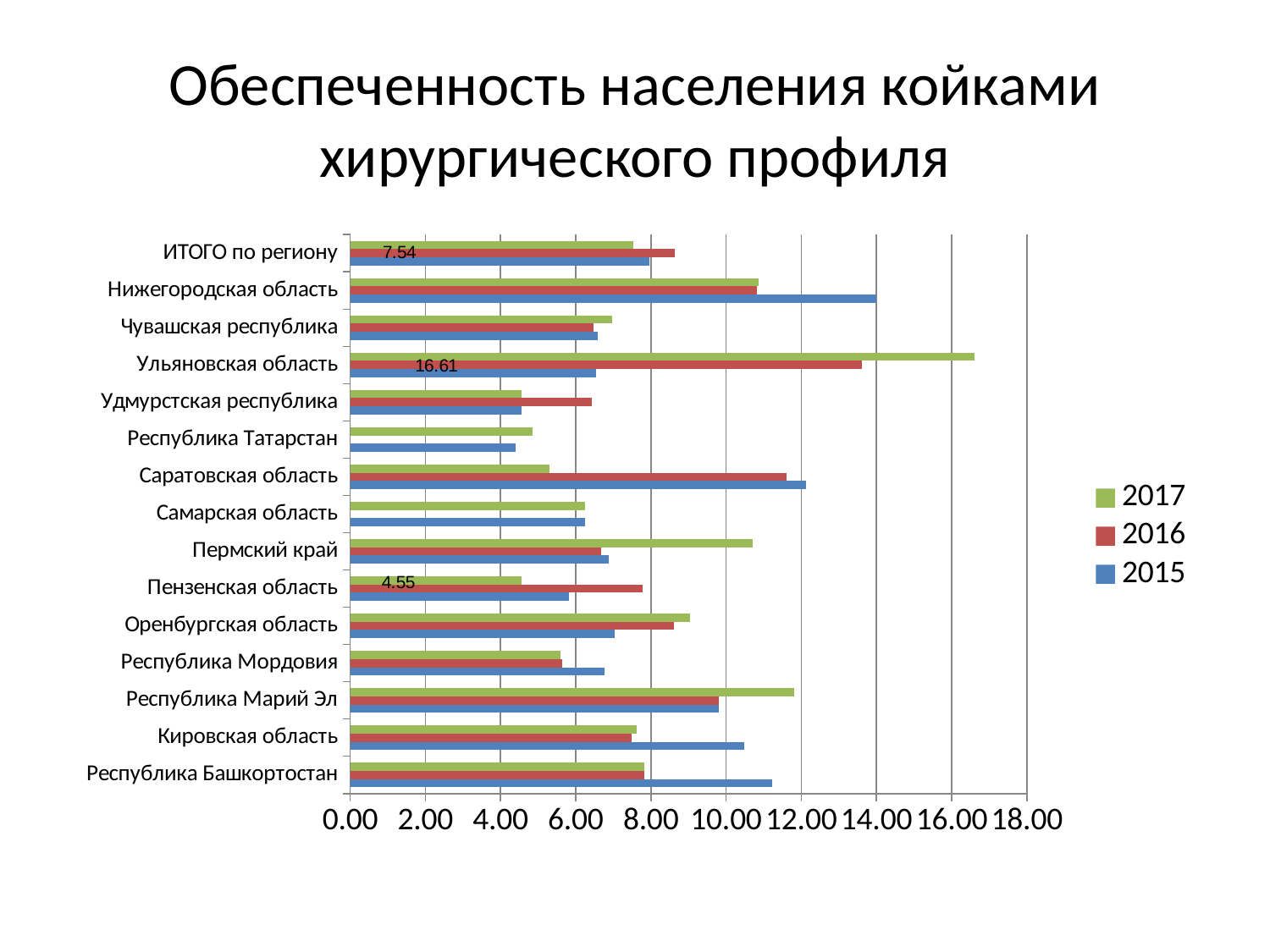
Which region has the highest 2015 value? Нижегородская область How many series does the legend list? 3 For Саратовская область, which is larger: the 2015 value or the 2017 value? 2015 What is the 2017 value for Пензенская область? 4.55 How many categories (regions, including the total) are shown on the chart? 15 What is the 2017 value for Ульяновская область? 16.61 For Пермский край, which is larger: the 2017 value or the 2015 value? 2017 Which region has the highest 2017 value? Ульяновская область Is the 2015 value for Нижегородская область greater or less than 12.00? greater Is the 2017 value for Самарская область greater or less than 8.00? less What is the 2017 value for ИТОГО по региону? 7.54 What is the difference between the 2017 values for Ульяновская область and Пензенская область? 12.06